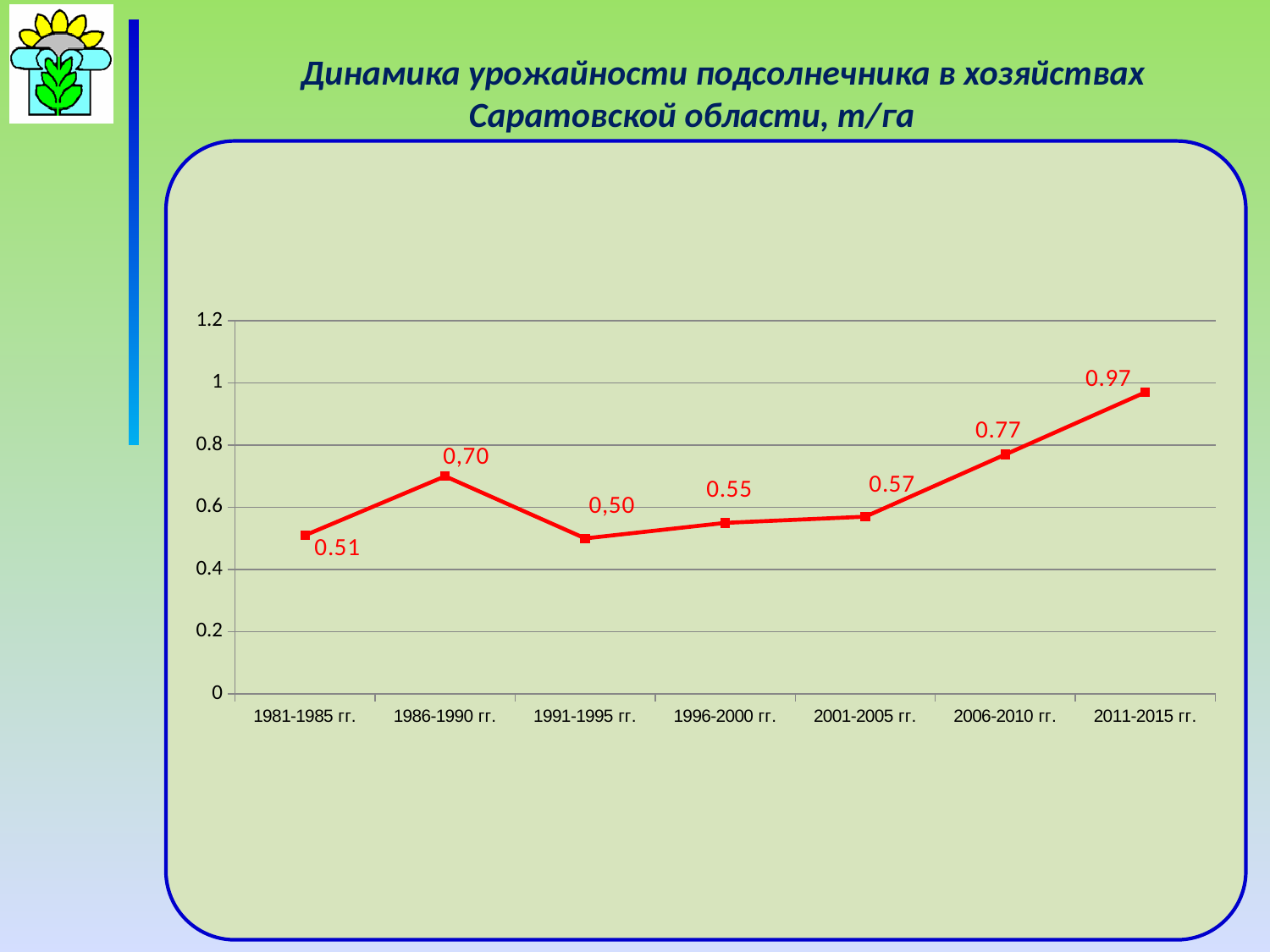
How many periods are plotted on the x axis? 7 Which period has the highest yield value? 2011-2015 гг. What is the value shown for 2001-2005 гг.? 0.57 What is the sunflower yield value for 1981-1985 гг.? 0.51 Which period has the lowest yield value? 1991-1995 гг. Is the value for 2006-2010 гг. greater or less than 0.6? greater What is the value shown for 1986-1990 гг.? 0,70 Do the values rise or fall from 2001-2005 гг. to 2011-2015 гг.? rise What kind of chart is shown on the slide? line chart Which is larger, the value for 1986-1990 гг. or the value for 1996-2000 гг.? 1986-1990 гг. What is the value shown for 2011-2015 гг.? 0.97 What is the difference between the values for 2011-2015 гг. and 2006-2010 гг.? 0.20